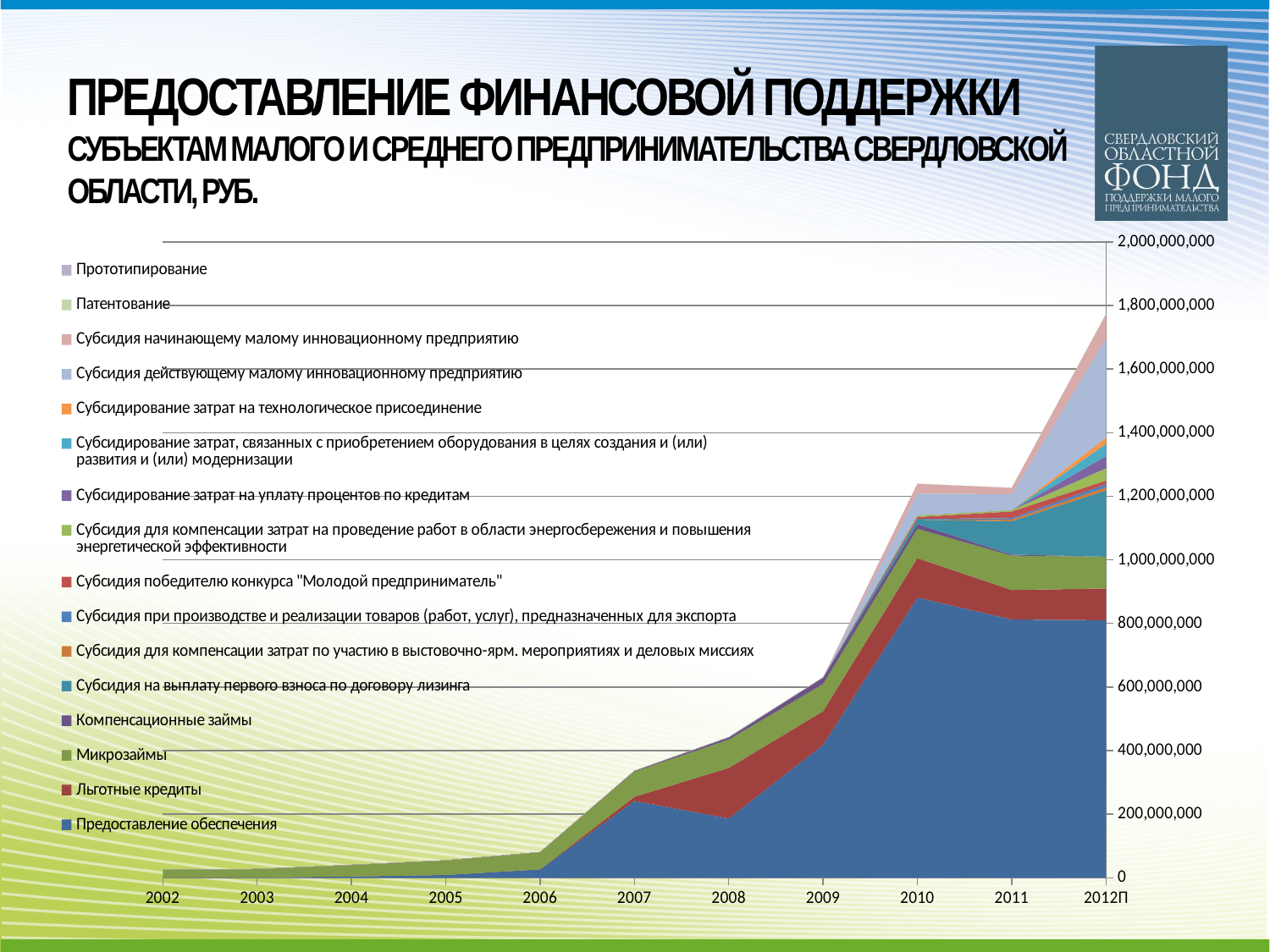
What kind of chart is shown on the slide? Stacked area chart Which series is listed last (at the bottom) in the chart's legend? Предоставление обеспечения Is the total value for 2006 greater or less than 200,000,000? less Is the total value for 2010 greater or less than 1,000,000,000? greater In which year is the total financial support lowest? 2002 How many years are shown along the x axis of the chart? 11 Which year has the larger total value, 2008 or 2009? 2009 Is the total value for 2008 greater or less than 600,000,000? less In which year is the total financial support highest? 2012П Do the total values in the chart generally rise or fall from 2002 to 2012П? Rise How many series does the chart's legend list? 16